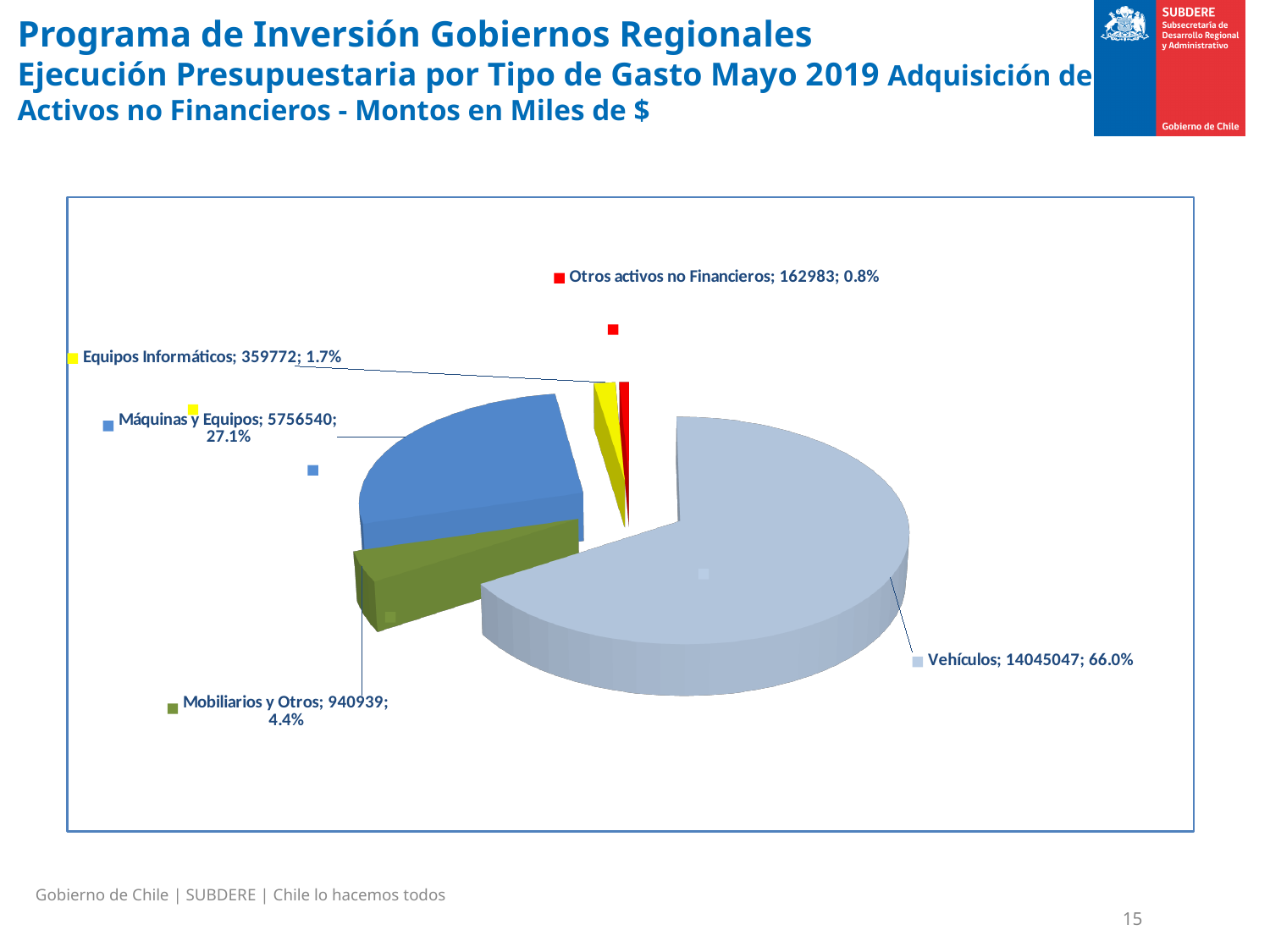
How many slices does the pie chart have? 5 What is the difference between the values for Vehículos and Máquinas y Equipos? 8288507 What is the value for Mobiliarios y Otros? 940939 What is the value for Máquinas y Equipos? 5756540 What is the value for Equipos Informáticos? 359772 Which category has the smallest slice of the pie? Otros activos no Financieros Which is larger, the value for Mobiliarios y Otros or the value for Equipos Informáticos? Mobiliarios y Otros What type of chart is shown on the slide? Pie chart What share of the pie does Máquinas y Equipos represent? 27.1% What share of the pie does Otros activos no Financieros represent? 0.8% Which category has the largest slice of the pie? Vehículos What is the value for Vehículos? 14045047